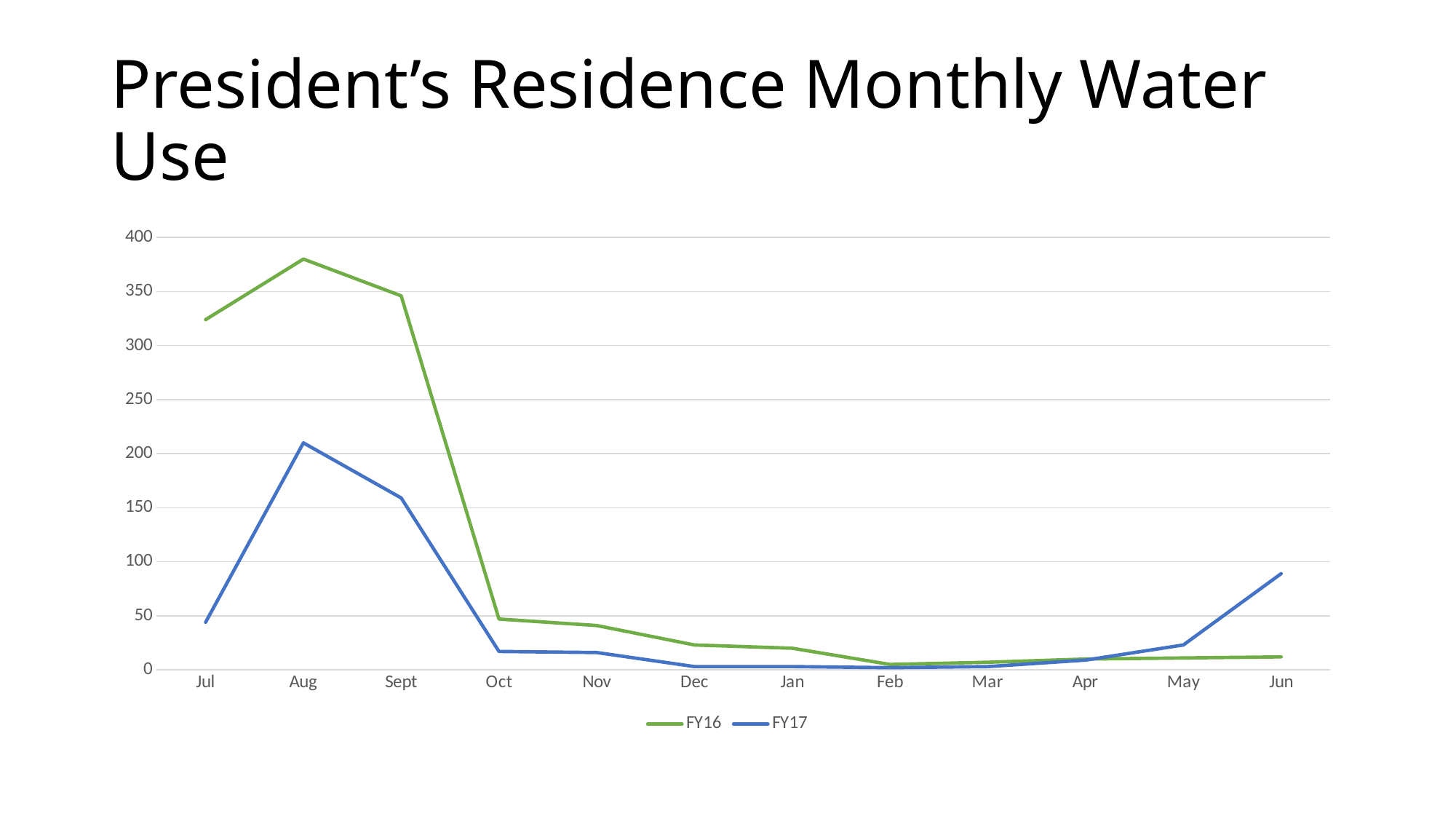
Is the FY16 value for Oct greater or less than 100? less In Aug, which series has the larger value, FY16 or FY17? FY16 How many months are plotted along the x axis? 12 In Jun, which series has the larger value, FY16 or FY17? FY17 Does the FY16 series rise or fall from Aug to Feb? fall Is the FY17 value for Jun greater or less than 100? less What kind of chart is shown on the slide? line chart In which month does the FY16 series reach its highest value? Aug In which month does the FY17 series reach its highest value? Aug Is the FY17 value for Sept greater or less than 200? less How many series does the legend list? 2